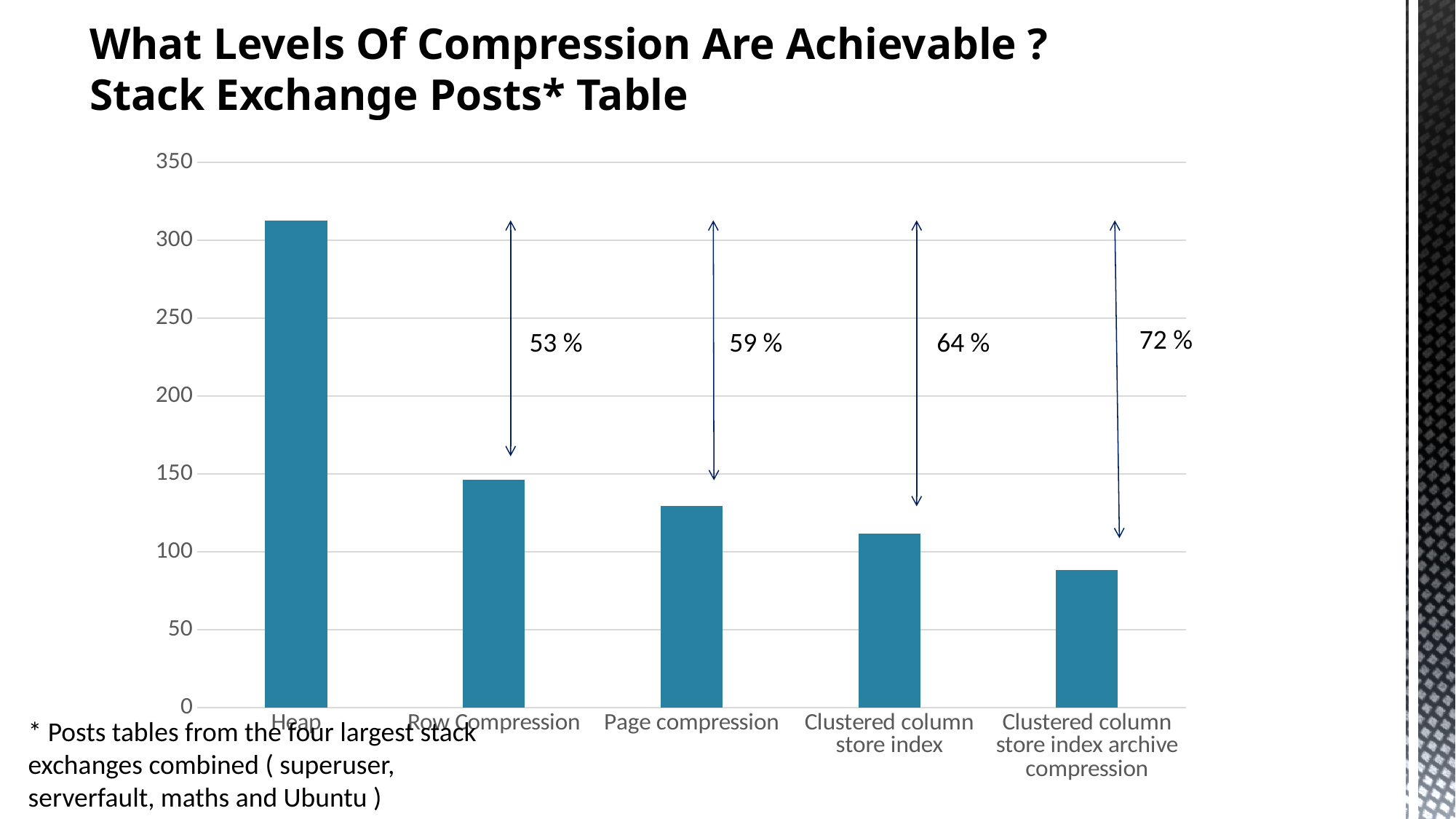
Do the bar values rise or fall moving from left to right across the categories? Fall Is the value for Heap greater or less than 300? greater Which category has the highest bar? Heap Which category has the lowest bar? Clustered column store index archive compression How many categories (bars) are plotted in the chart? 5 Which is larger, the value for Page compression or the value for Clustered column store index? Page compression What compression percentage is annotated above the Row Compression bar? 53 % What compression percentage is annotated above the Clustered column store index archive compression bar? 72 % Is the value for Clustered column store index archive compression greater or less than 100? less Is the value for Clustered column store index greater or less than 100? greater What type of chart is shown on the slide? Bar chart